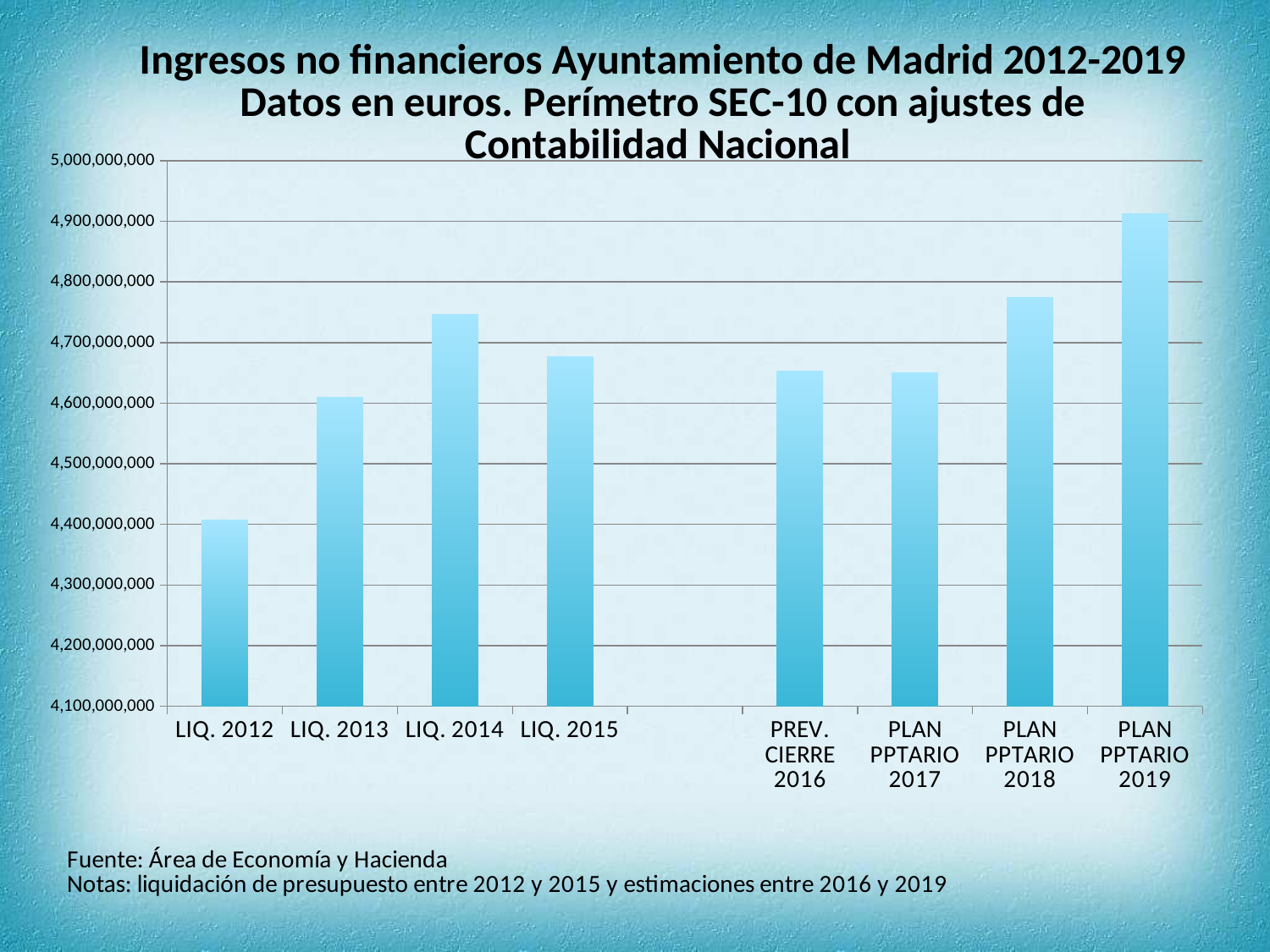
Is the value for LIQ. 2012 greater or less than 4,500,000,000? less Is the value for LIQ. 2014 greater or less than 4,700,000,000? greater Which is larger, the value for LIQ. 2013 or the value for LIQ. 2014? LIQ. 2014 What kind of chart is shown on the slide? bar chart Is the value for PLAN PPTARIO 2019 greater or less than 4,800,000,000? greater Do the values rise or fall from LIQ. 2012 to LIQ. 2014? rise How many bars (categories) are plotted in the chart? 8 Which is larger, the value for LIQ. 2015 or the value for PLAN PPTARIO 2019? PLAN PPTARIO 2019 According to the slide, what is the source of the data in the chart? Área de Economía y Hacienda Which category has the lowest value in the chart? LIQ. 2012 Which category has the highest value in the chart? PLAN PPTARIO 2019